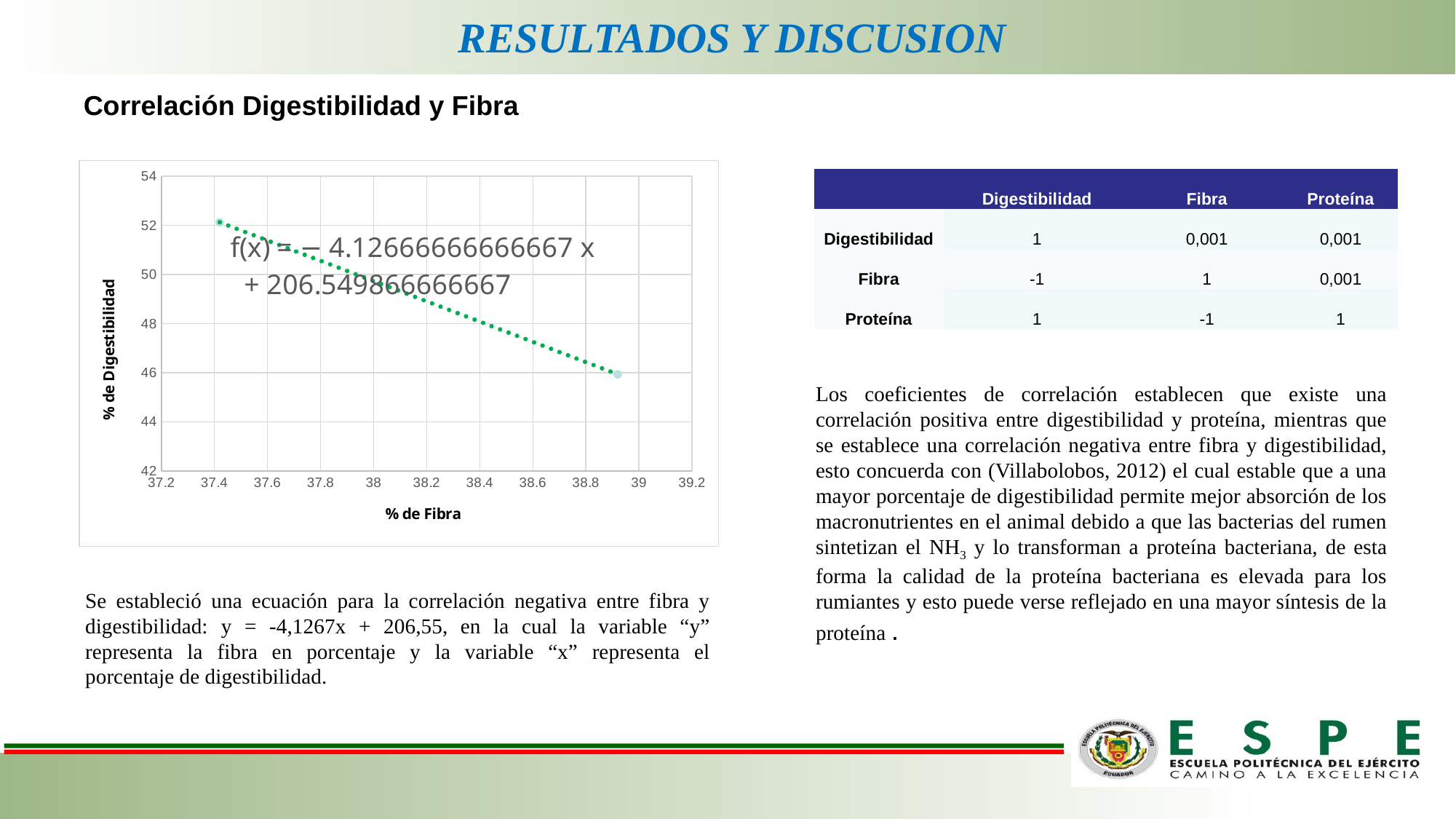
What is the title of the y axis of the chart? % de Digestibilidad Which point has the higher % de Digestibilidad: the leftmost point or the rightmost point? The leftmost point What is the slope of the trendline equation displayed on the chart? -4.12666666666667 As % de Fibra increases along the x axis, does % de Digestibilidad rise or fall? Fall Is the % de Digestibilidad of the rightmost point (near 38.9 % de Fibra) greater or less than 48? less How many data points are plotted in the chart? 2 What kind of chart is shown on the slide? Scatter chart Does the point with the lowest % de Fibra have the highest or the lowest % de Digestibilidad? Highest What is the title of the x axis of the chart? % de Fibra What is the intercept of the trendline equation displayed on the chart? 206.549866666667 Is the % de Digestibilidad of the leftmost point (near 37.4 % de Fibra) greater or less than 50? greater